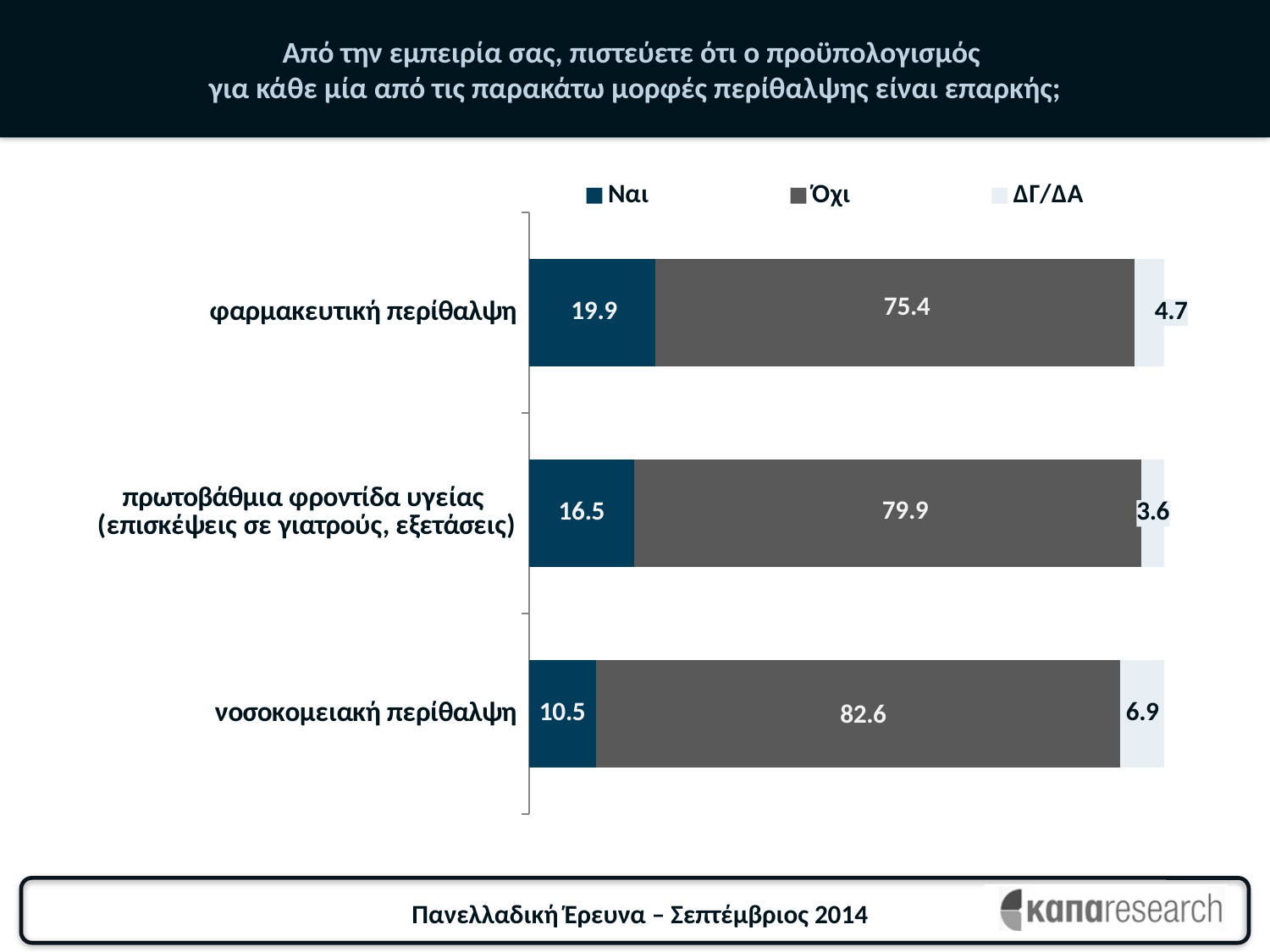
What is the Όχι value for νοσοκομειακή περίθαλψη? 82.6 Which category has the lowest Ναι value? νοσοκομειακή περίθαλψη What is the difference between the Ναι values for φαρμακευτική περίθαλψη and νοσοκομειακή περίθαλψη? 9.4 What is the difference between the Όχι values for νοσοκομειακή περίθαλψη and φαρμακευτική περίθαλψη? 7.2 How many categories are shown in the chart? 3 What is the ΔΓ/ΔΑ value for πρωτοβάθμια φροντίδα υγείας (επισκέψεις σε γιατρούς, εξετάσεις)? 3.6 What kind of chart is shown on the slide? Stacked bar chart What is the total of the stacked bar for πρωτοβάθμια φροντίδα υγείας (επισκέψεις σε γιατρούς, εξετάσεις)? 100.0 Which category has the highest Όχι value? νοσοκομειακή περίθαλψη How many series does the legend list? 3 Which is larger: the ΔΓ/ΔΑ value for νοσοκομειακή περίθαλψη or for φαρμακευτική περίθαλψη? νοσοκομειακή περίθαλψη What is the Ναι value for φαρμακευτική περίθαλψη? 19.9